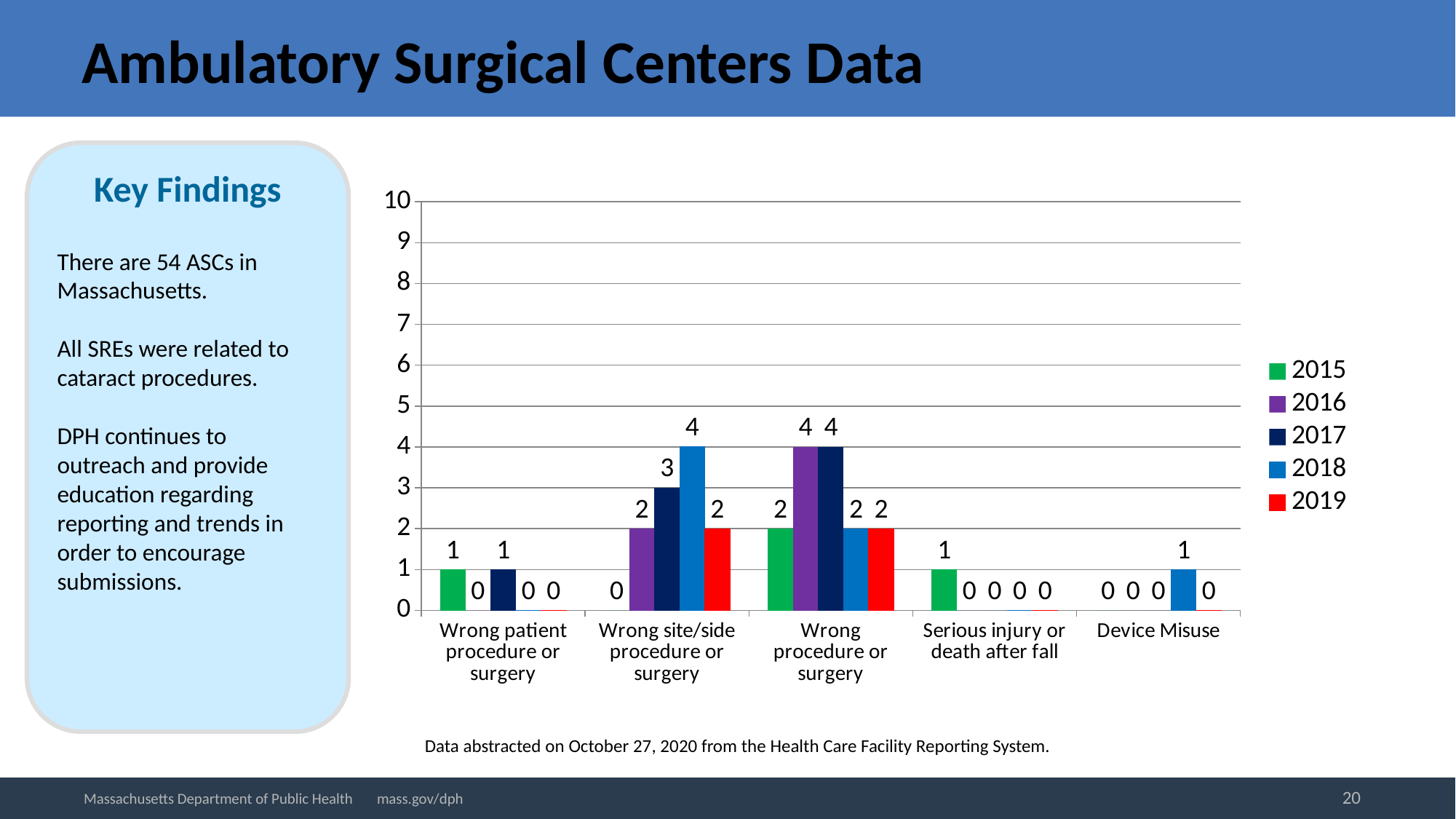
What is the value for 2015 in the Wrong procedure or surgery category? 2 Which colour represents 2019 in the legend? red What is the value for 2018 in the Device Misuse category? 1 What is the value for 2018 in the Wrong site/side procedure or surgery category? 4 What kind of chart is shown on the slide? bar chart How many categories are shown on the x axis? 5 Which is larger in the Wrong procedure or surgery category, the value for 2016 or the value for 2018? 2016 Which year has the highest value in the Wrong site/side procedure or surgery category? 2018 Which year is the only one with a non-zero value in the Serious injury or death after fall category? 2015 What is the difference between the 2018 and 2016 values in the Wrong site/side procedure or surgery category? 2 What is the value for 2017 in the Wrong site/side procedure or surgery category? 3 How many series does the legend list? 5